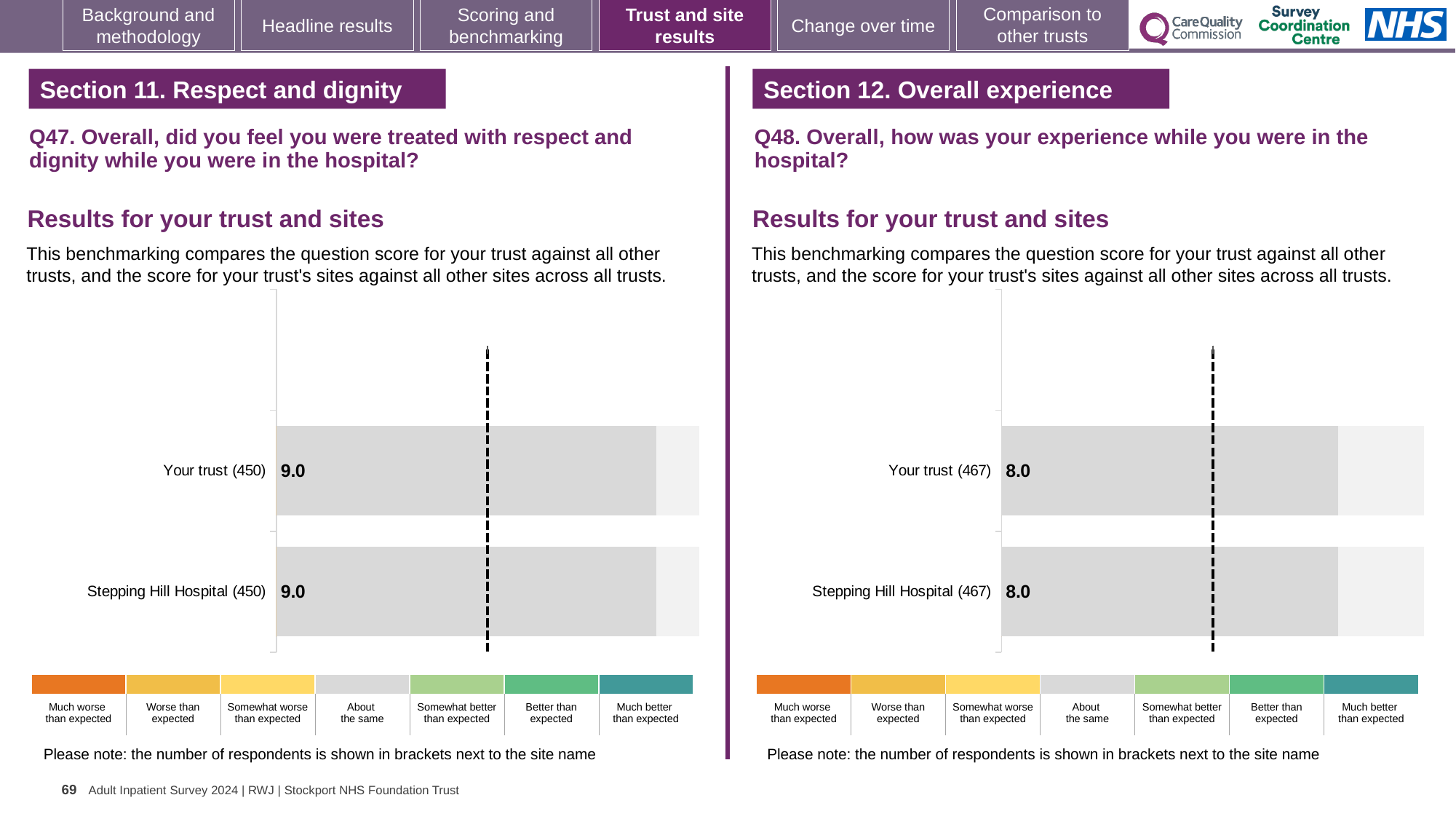
In the left chart (Q47), how many respondents are shown in brackets next to Your trust? 450 In the left chart (Q47, Respect and dignity), what is the score for Your trust? 9.0 Is the score for Your trust in the left chart (Q47) larger or smaller than the score for Your trust in the right chart (Q48)? Larger What is the difference between the Stepping Hill Hospital score in the left chart (Q47) and the Stepping Hill Hospital score in the right chart (Q48)? 1.0 What kind of chart is used in the left chart (Q47)? Bar chart In the right chart (Q48, Overall experience), what is the score for Your trust? 8.0 How many bars are plotted in the left chart (Q47)? 2 How many bars are plotted in the right chart (Q48)? 2 In the right chart (Q48, Overall experience), what is the score for Stepping Hill Hospital? 8.0 In the right chart (Q48), how many respondents are shown in brackets next to Stepping Hill Hospital? 467 In the left chart (Q47, Respect and dignity), what is the score for Stepping Hill Hospital? 9.0